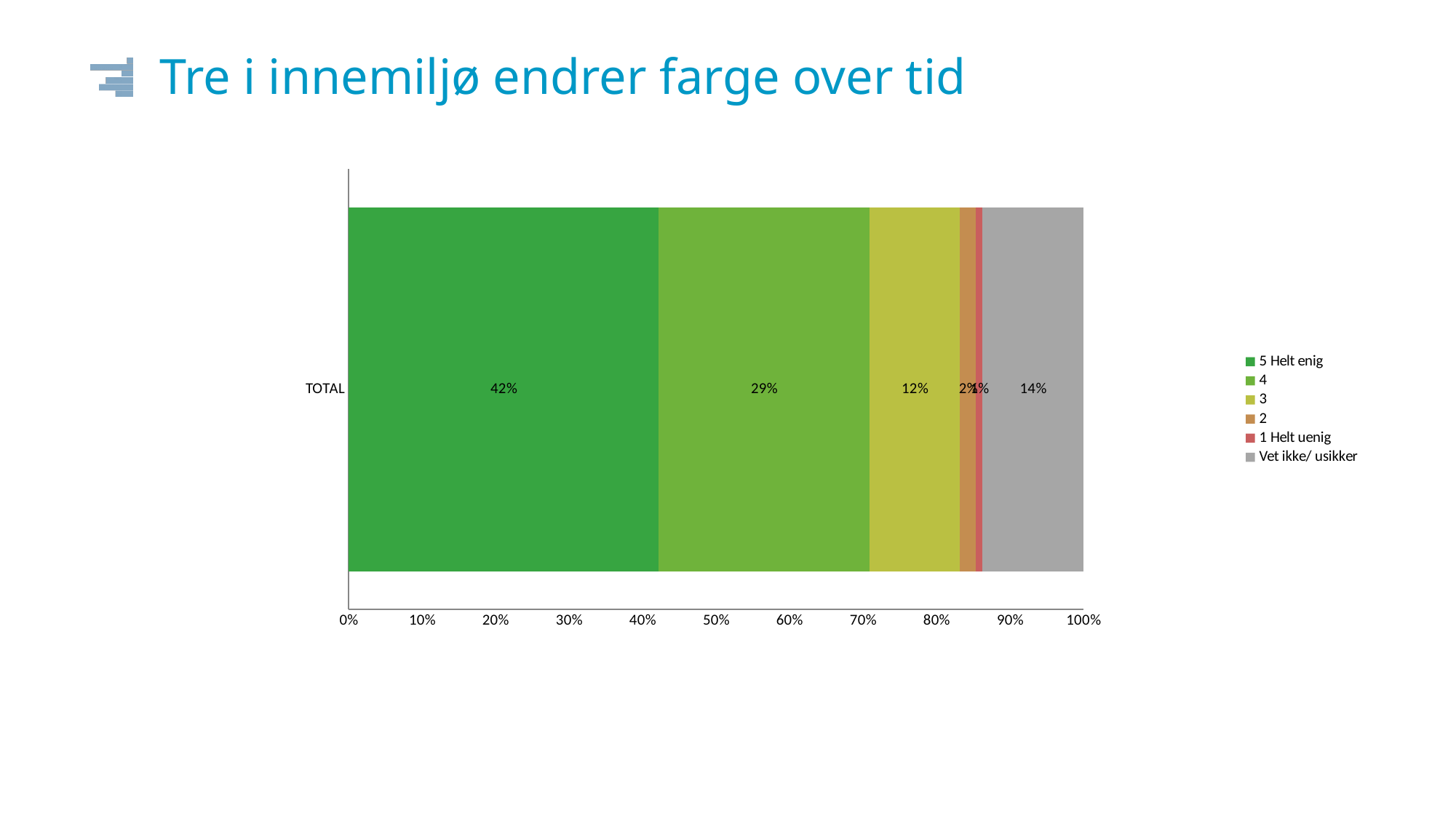
What kind of chart is shown on the slide? Stacked bar chart What is the value for series "3" in the TOTAL bar? 12% Which is larger in the TOTAL bar: "Vet ikke/ usikker" or "3"? Vet ikke/ usikker How many series does the legend list? 6 How many categories are shown on the vertical axis? 1 What is the difference between the "5 Helt enig" and "4" values in the TOTAL bar? 13% Which series has the smallest share of the TOTAL bar? 1 Helt uenig What is the value for "Vet ikke/ usikker" in the TOTAL bar? 14% Which series has the largest share of the TOTAL bar? 5 Helt enig What is the value for "5 Helt enig" in the TOTAL bar? 42% What is the title of the slide containing the chart? Tre i innemiljø endrer farge over tid What is the value for series "4" in the TOTAL bar? 29%